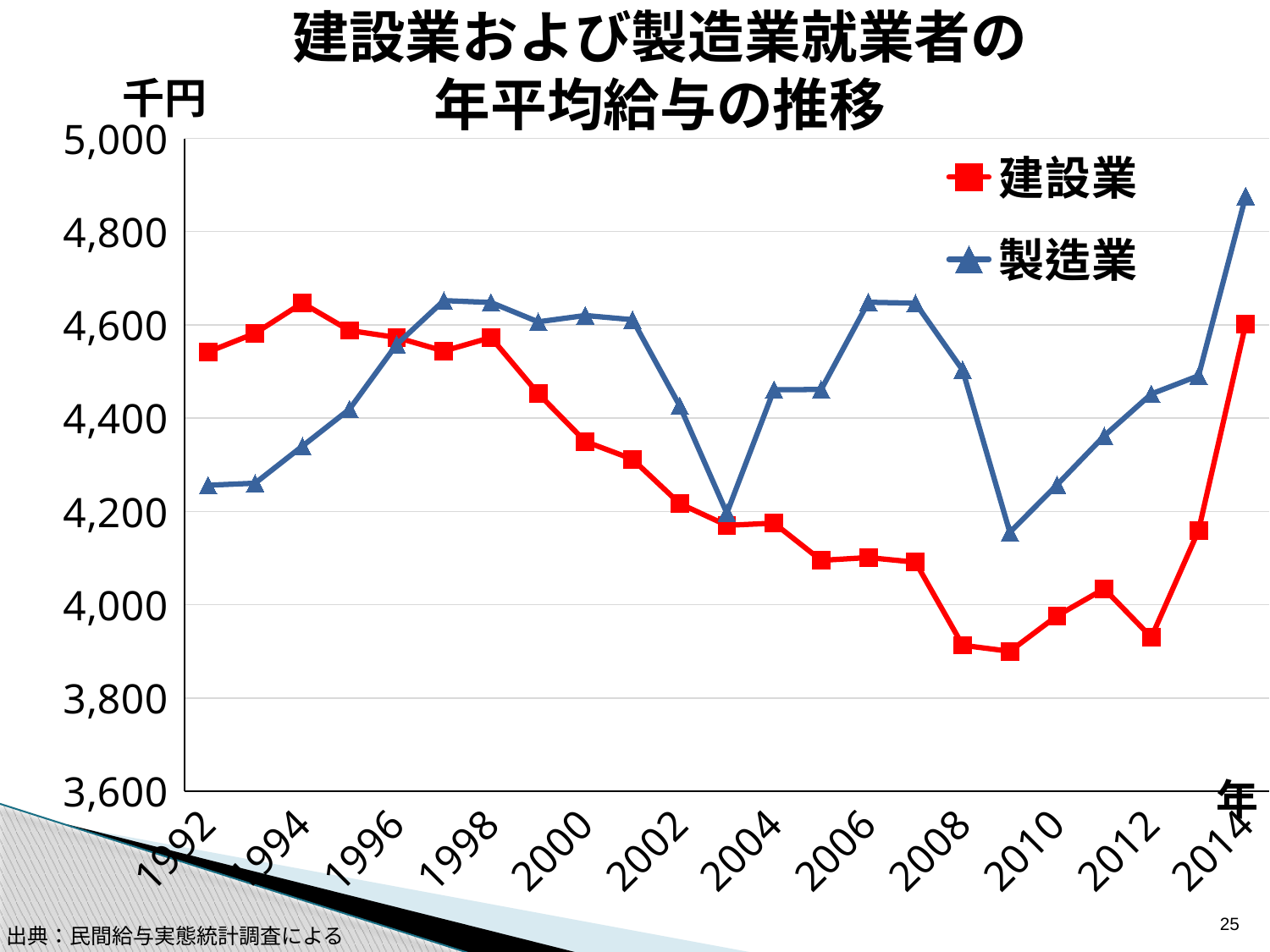
In which year does the 製造業 series reach its highest value? 2014 Is the value for 製造業 in 2014 greater or less than 4,800? greater Is the value for 建設業 in 2009 greater or less than 4,000? less Is the value for 製造業 in 1992 greater or less than 4,400? less How many series does the legend list? 2 How many years are plotted along the x axis for each series? 23 What unit is shown at the top of the vertical axis? 千円 In 1992, which series has the higher value, 建設業 or 製造業? 建設業 What kind of chart is shown on the slide? line chart What are the two series named in the legend? 建設業 and 製造業 In 2014, which series has the higher value, 建設業 or 製造業? 製造業